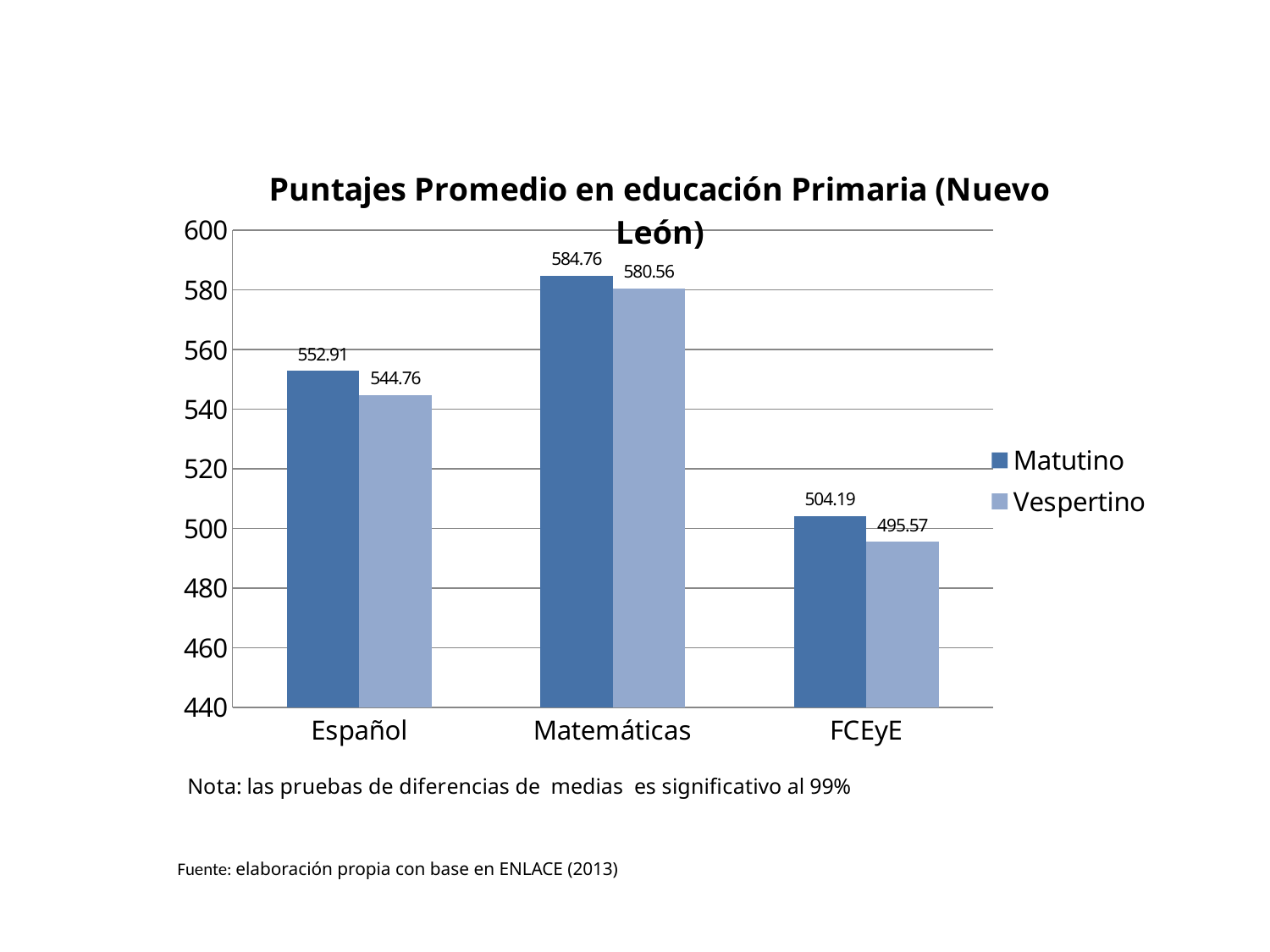
What is the difference between the Matutino and Vespertino scores for FCEyE? 8.62 What kind of chart is shown on the slide? bar chart How many series does the legend list? 2 What is the Matutino value for Español? 552.91 Which subject has the lowest Vespertino score? FCEyE How many subject categories are shown on the x axis? 3 Which is larger for Matemáticas, the Matutino or the Vespertino score? Matutino What is the difference between the Matutino and Vespertino scores for Español? 8.15 Is the Matutino value for FCEyE greater or less than 500? greater What is the Vespertino value for Matemáticas? 580.56 What is the Vespertino value for FCEyE? 495.57 Which subject has the highest Matutino score? Matemáticas